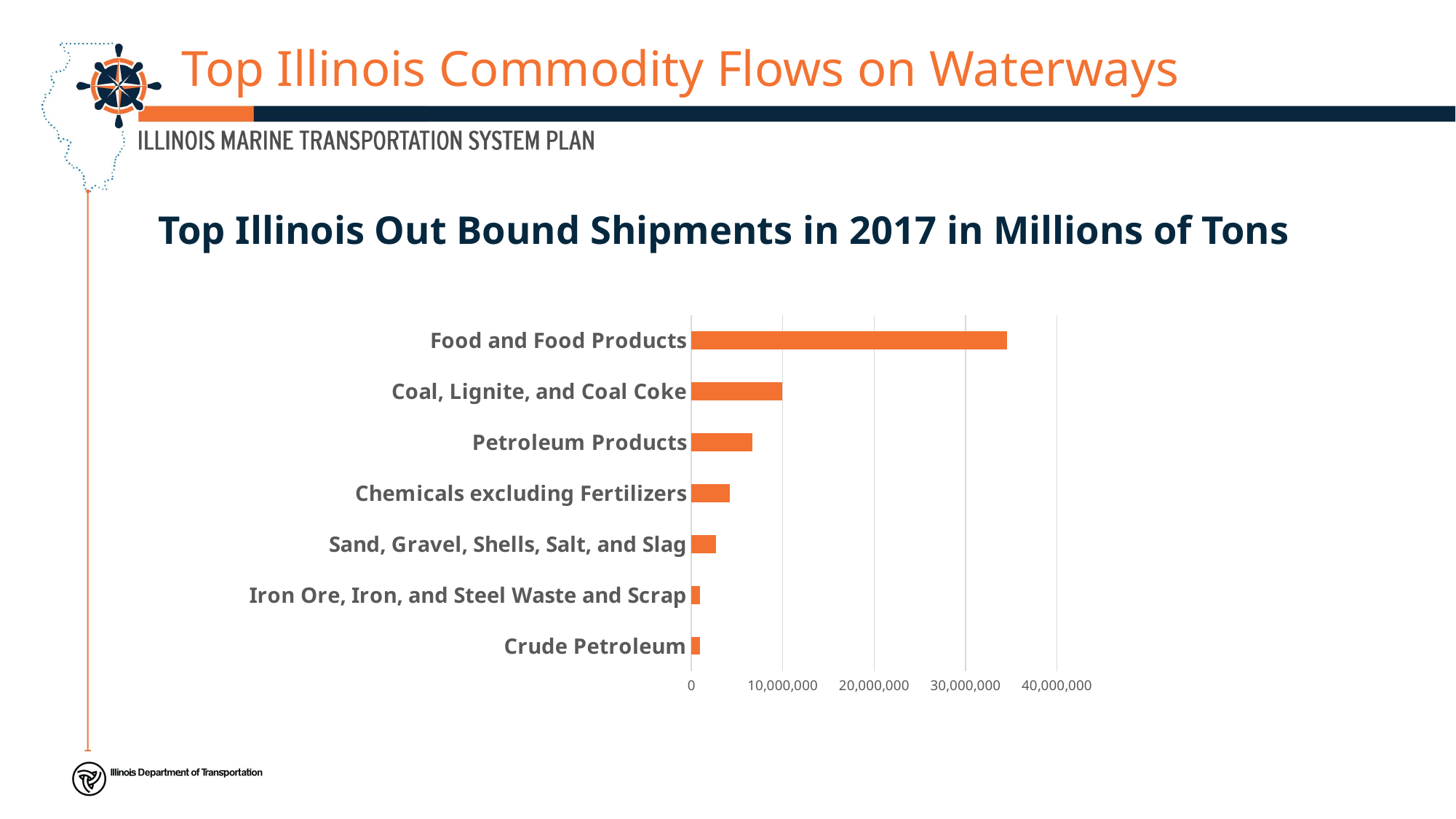
Which commodity has the highest outbound shipment value in the chart? Food and Food Products Which is larger, the value for Chemicals excluding Fertilizers or the value for Sand, Gravel, Shells, Salt, and Slag? Chemicals excluding Fertilizers What kind of chart is shown on the slide? bar chart What is the largest value labelled on the horizontal axis? 40,000,000 How many commodity categories are plotted in the chart? 7 Is the value for Food and Food Products greater or less than 30,000,000? greater What is the title of the chart? Top Illinois Out Bound Shipments in 2017 in Millions of Tons Which is larger, the value for Coal, Lignite, and Coal Coke or the value for Petroleum Products? Coal, Lignite, and Coal Coke Is the value for Petroleum Products greater or less than 10,000,000? less Do the bar values increase or decrease going from the top category to the bottom category? decrease Is the value for Chemicals excluding Fertilizers greater or less than 10,000,000? less